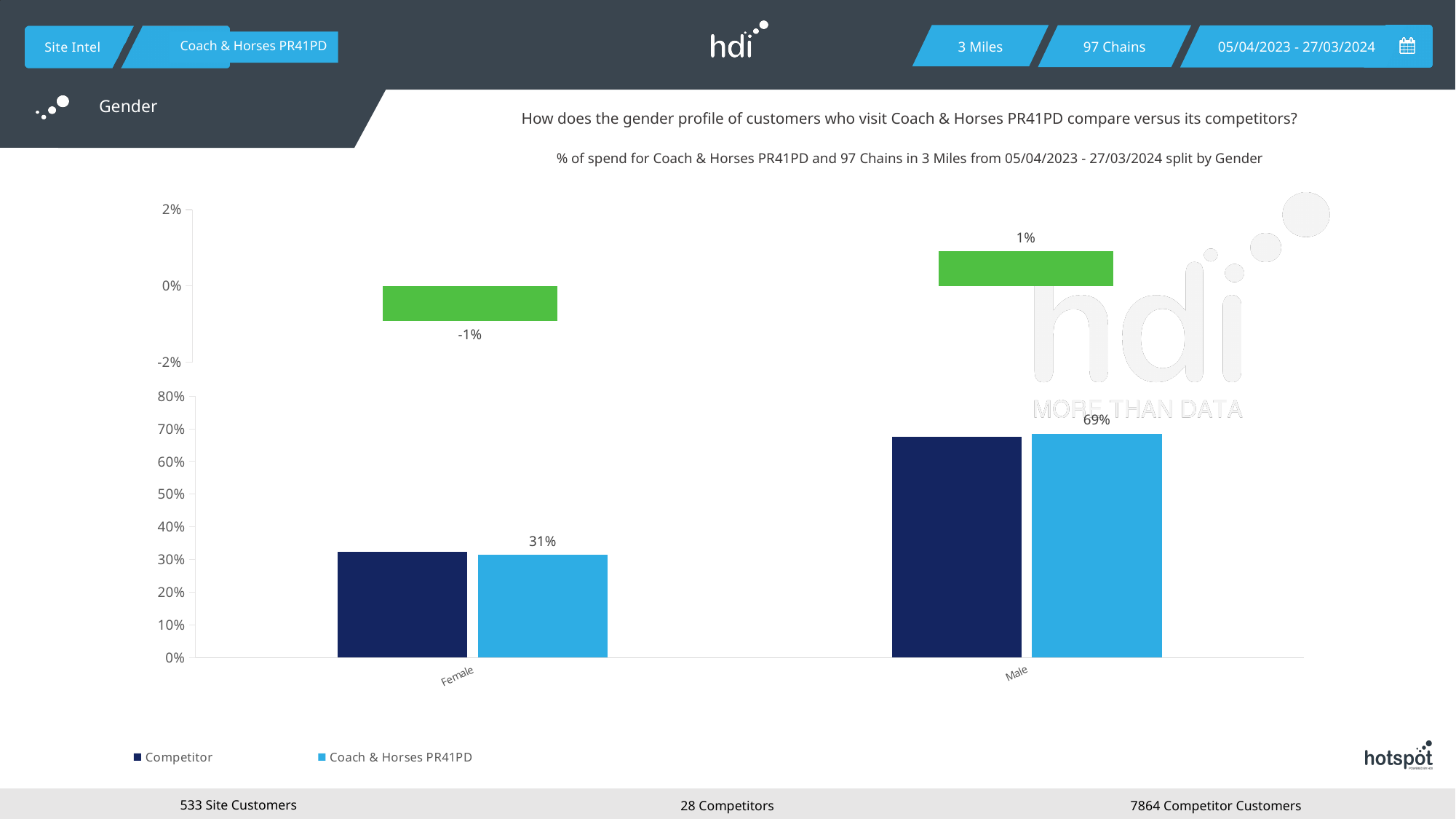
In the bottom chart, which gender category has the higher value for Coach & Horses PR41PD? Male In the top chart, what is the value shown for Female? -1% In the bottom chart, is the Competitor value for Male greater or less than 60%? greater In the bottom chart, which colour represents the Competitor series? Dark navy blue In the top chart, what is the value shown for Male? 1% How many gender categories are shown on the x axis of the bottom chart? 2 In the bottom chart, what is the difference between the Coach & Horses PR41PD values for Male and Female? 38% What type of chart is the bottom chart? Bar chart In the bottom chart, what is the value for Coach & Horses PR41PD for Male? 69% In the bottom chart, what is the value for Coach & Horses PR41PD for Female? 31% In the bottom chart, is the Competitor value for Female greater or less than 40%? less How many series does the legend of the bottom chart list? 2